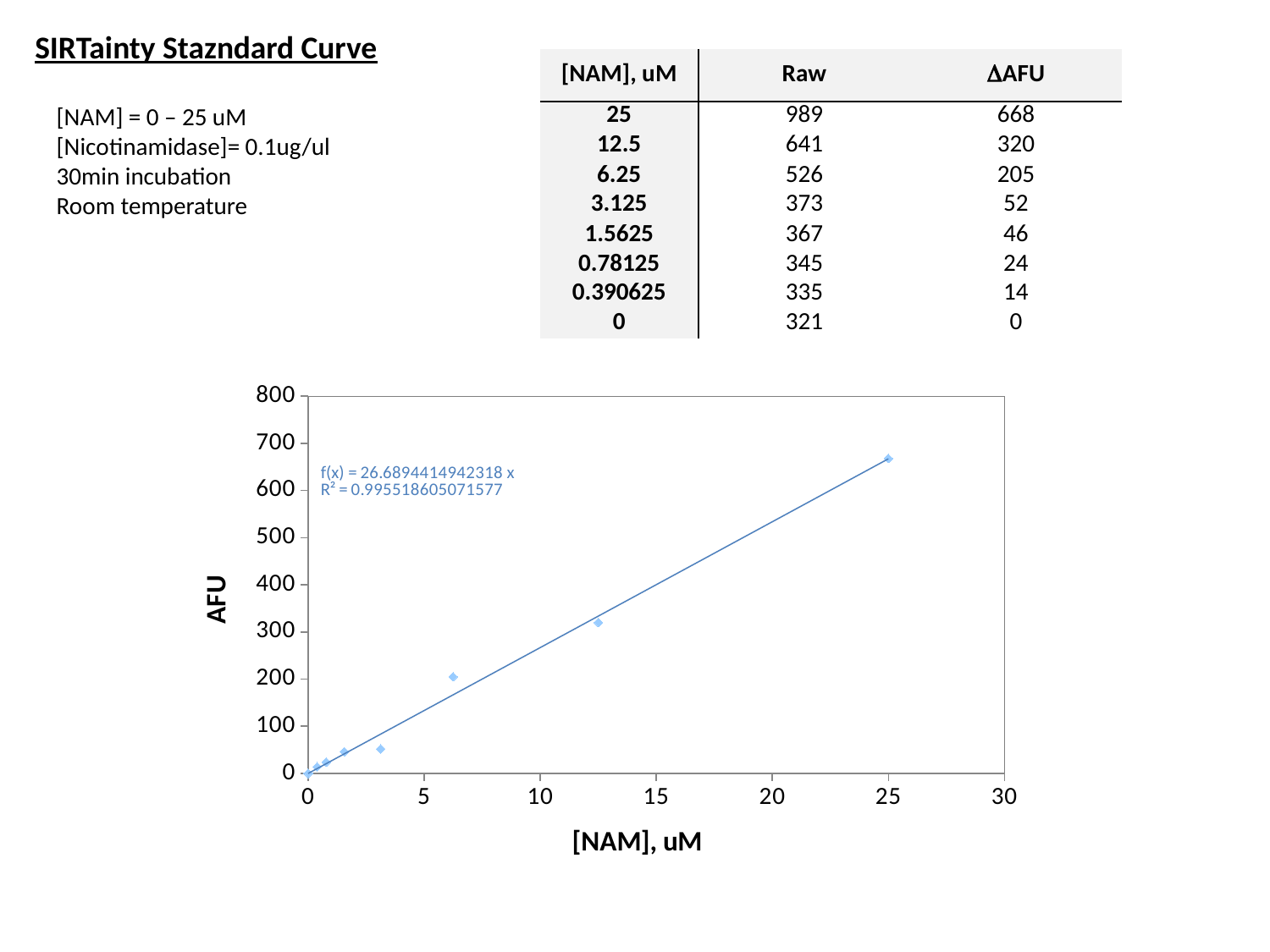
What is the difference between the ΔAFU values at 25 uM and 12.5 uM [NAM]? 348 Which has the larger plotted AFU value: 12.5 uM or 6.25 uM [NAM]? 12.5 uM Is the AFU value plotted at 12.5 uM [NAM] greater or less than 400? less At which [NAM] concentration is the plotted AFU value highest? 25 Do the plotted AFU values rise or fall as [NAM] increases along the x axis? rise Is the AFU value plotted at 6.25 uM [NAM] greater or less than 100? greater What kind of chart is shown on the slide? scatter chart What is the ΔAFU value plotted for 25 uM [NAM]? 668 How many data points are plotted on the chart? 8 What is the label of the x axis of the chart? [NAM], uM What is the label of the y axis of the chart? AFU Is the AFU value plotted at 25 uM [NAM] greater or less than 600? greater